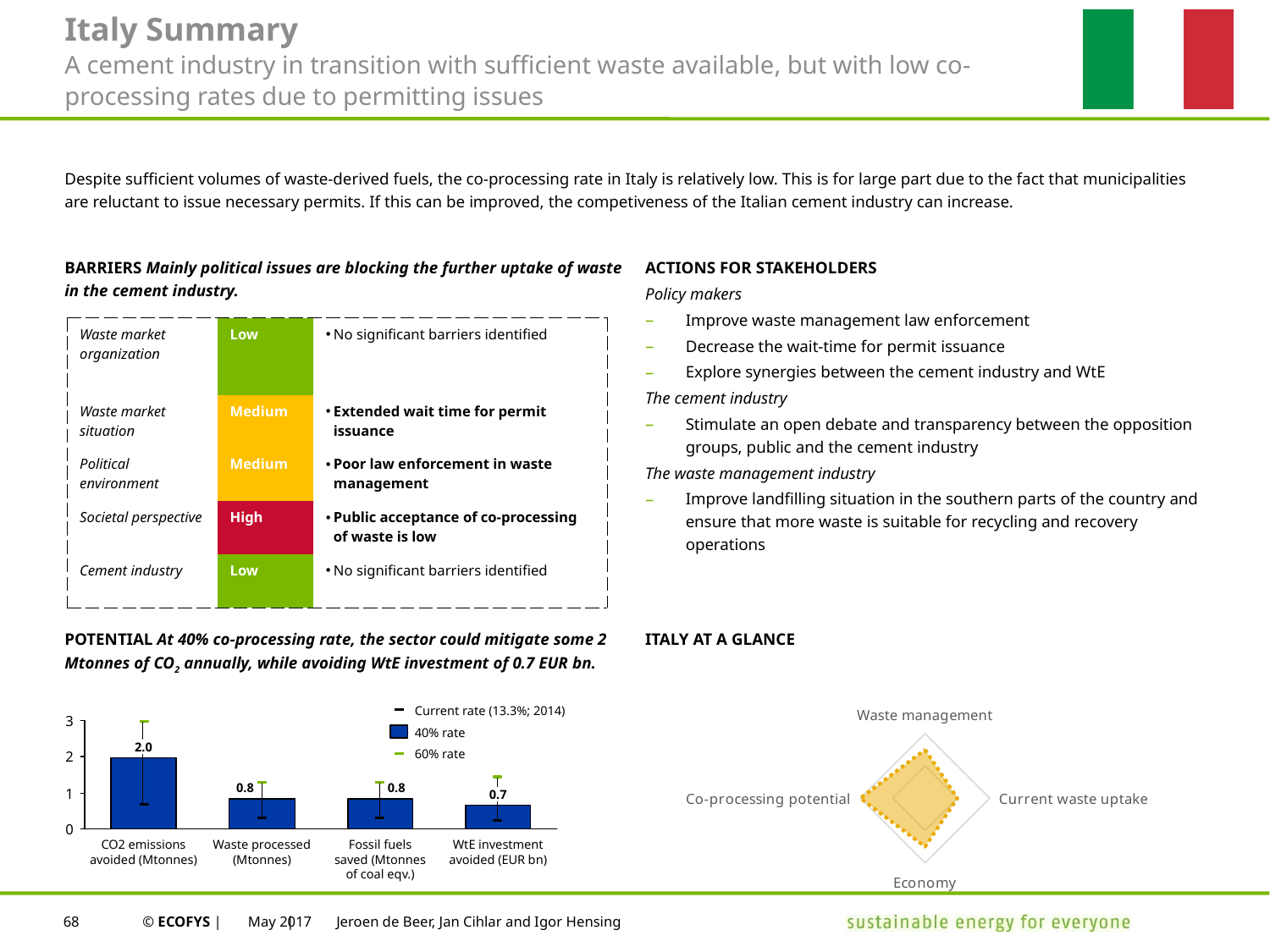
In the bar chart under POTENTIAL, which category has the highest 40% rate bar? CO2 emissions avoided (Mtonnes) In the bar chart under POTENTIAL, what is the value for CO2 emissions avoided (Mtonnes) at the 40% rate? 2.0 In the bar chart under POTENTIAL, how many entries does the legend list? 3 What kind of chart is shown under the POTENTIAL heading? Bar chart In the bar chart under POTENTIAL, what current co-processing rate is given in the legend? 13.3% In the ITALY AT A GLANCE chart, how many axes (dimensions) are labelled? 4 In the bar chart under POTENTIAL, what is the value for WtE investment avoided (EUR bn) at the 40% rate? 0.7 In the bar chart under POTENTIAL, what is the value for Waste processed (Mtonnes) at the 40% rate? 0.8 In the bar chart under POTENTIAL, what is the difference between the 40% rate values for CO2 emissions avoided and Waste processed? 1.2 In the bar chart under POTENTIAL, is the 40% rate bar for CO2 emissions avoided greater or less than 1? greater In the bar chart under POTENTIAL, which category has the lowest 40% rate bar? WtE investment avoided (EUR bn) In the bar chart under POTENTIAL, how many categories are shown on the x axis? 4